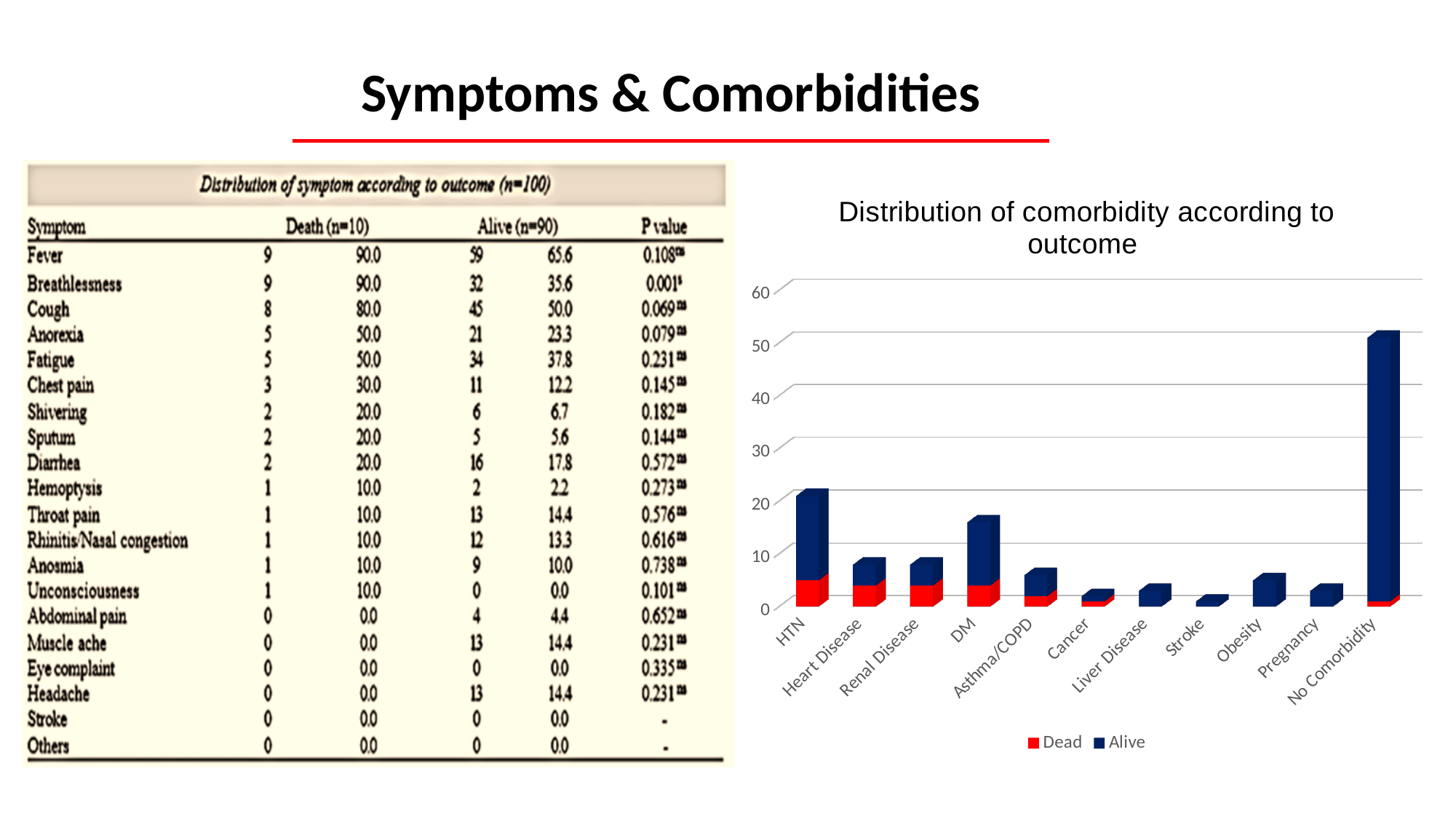
In the 'Distribution of comorbidity according to outcome' chart, is the total bar for No Comorbidity greater or less than 40? greater In the 'Distribution of comorbidity according to outcome' chart, which category has the tallest bar? No Comorbidity In the 'Distribution of comorbidity according to outcome' chart, is the total bar for HTN greater or less than 10? greater In the 'Distribution of comorbidity according to outcome' chart, which colour represents the 'Dead' series? Red In the 'Distribution of comorbidity according to outcome' chart, which has the taller bar, HTN or DM? HTN How many comorbidity categories are shown on the x axis of the 'Distribution of comorbidity according to outcome' chart? 11 How many series does the legend of the 'Distribution of comorbidity according to outcome' chart list? 2 What is the title of the bar chart on the right side of the slide? Distribution of comorbidity according to outcome In the 'Distribution of comorbidity according to outcome' chart, is the total bar for DM greater or less than 20? less In the 'Distribution of comorbidity according to outcome' chart, which category has the shortest bar? Stroke What kind of chart is 'Distribution of comorbidity according to outcome'? Stacked bar chart